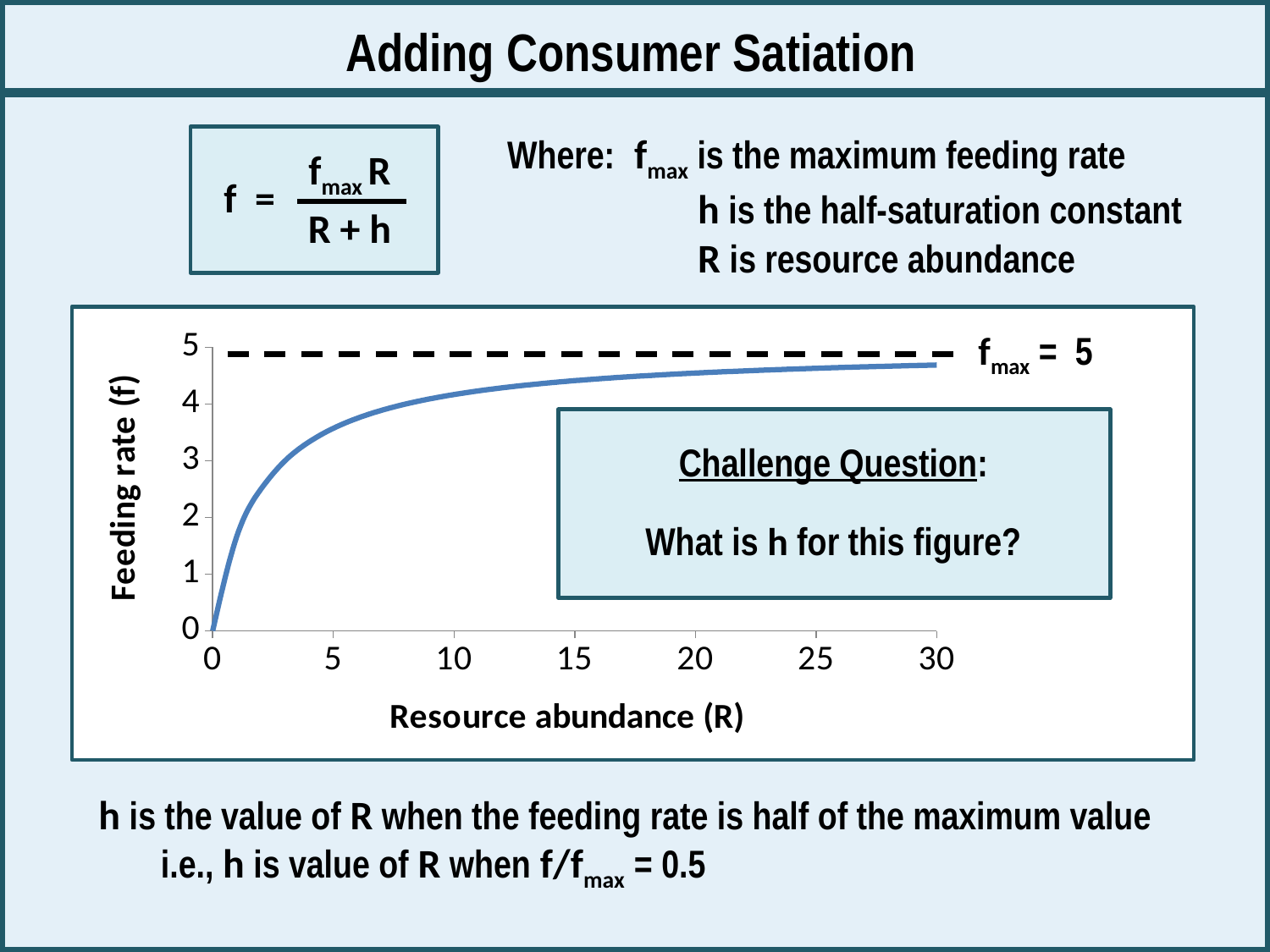
Is the feeding rate at a resource abundance of 30 greater or less than 5? less Is the feeding rate at a resource abundance of 10 greater or less than 3? greater How many tick labels are shown on the x axis of the chart? 7 Does the feeding rate rise or fall as resource abundance increases along the x axis? rise Is the feeding rate at a resource abundance of 30 greater or less than 4? greater What is the label of the y axis of the chart? Feeding rate (f) What value of f_max is indicated by the dashed line on the chart? 5 What kind of chart is shown on the slide? line chart What is the highest tick value shown on the x axis of the chart? 30 What is the label of the x axis of the chart? Resource abundance (R)